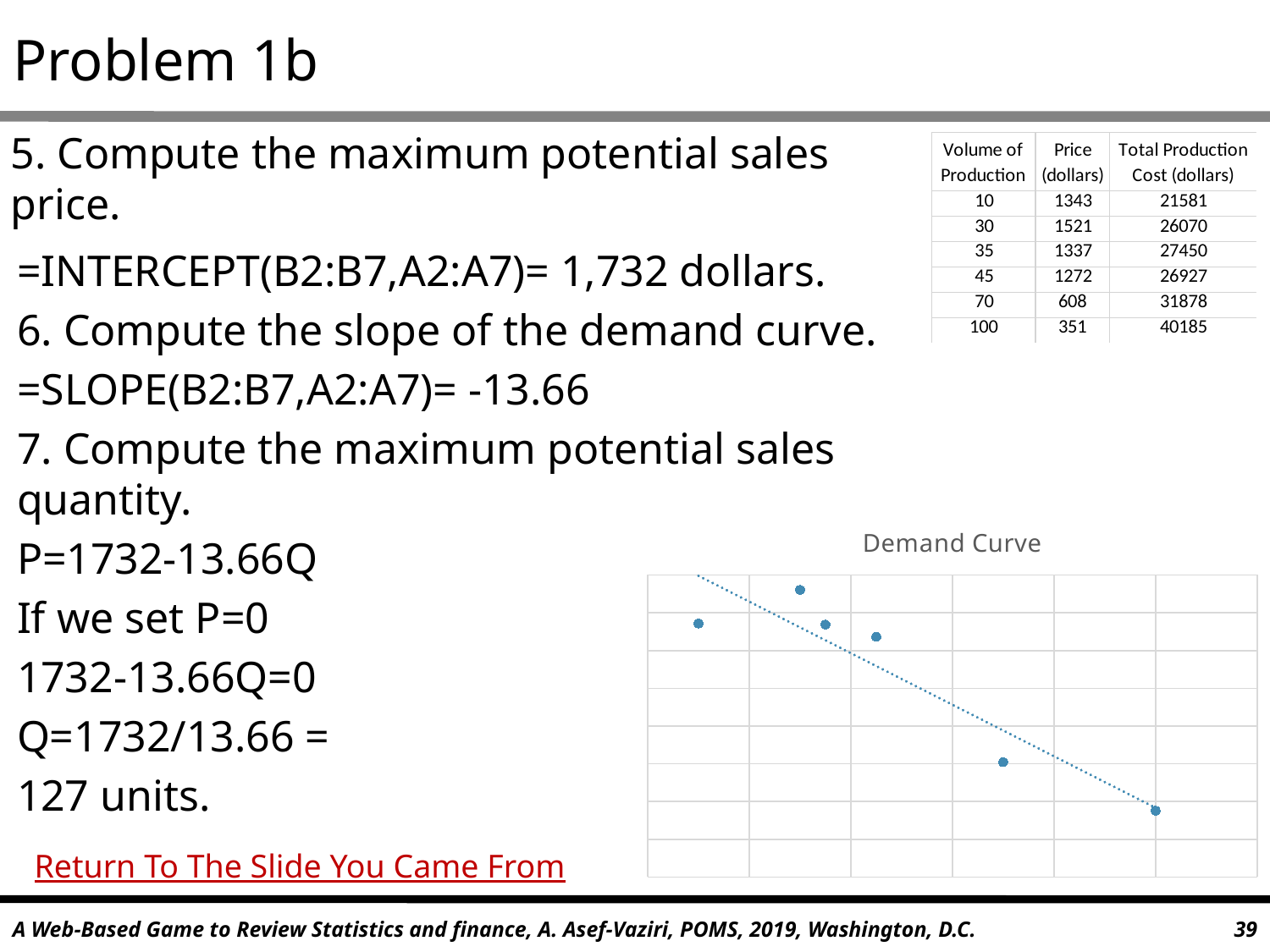
How many data points are plotted in the "Demand Curve" chart? 6 What kind of chart is the "Demand Curve" chart? scatter plot Do the plotted points in the "Demand Curve" chart generally rise or fall from left to right? fall Does the dotted trendline in the "Demand Curve" chart slope upward or downward? downward Does the "Demand Curve" chart include a trendline through the points? yes What is the title of the chart on the slide? Demand Curve